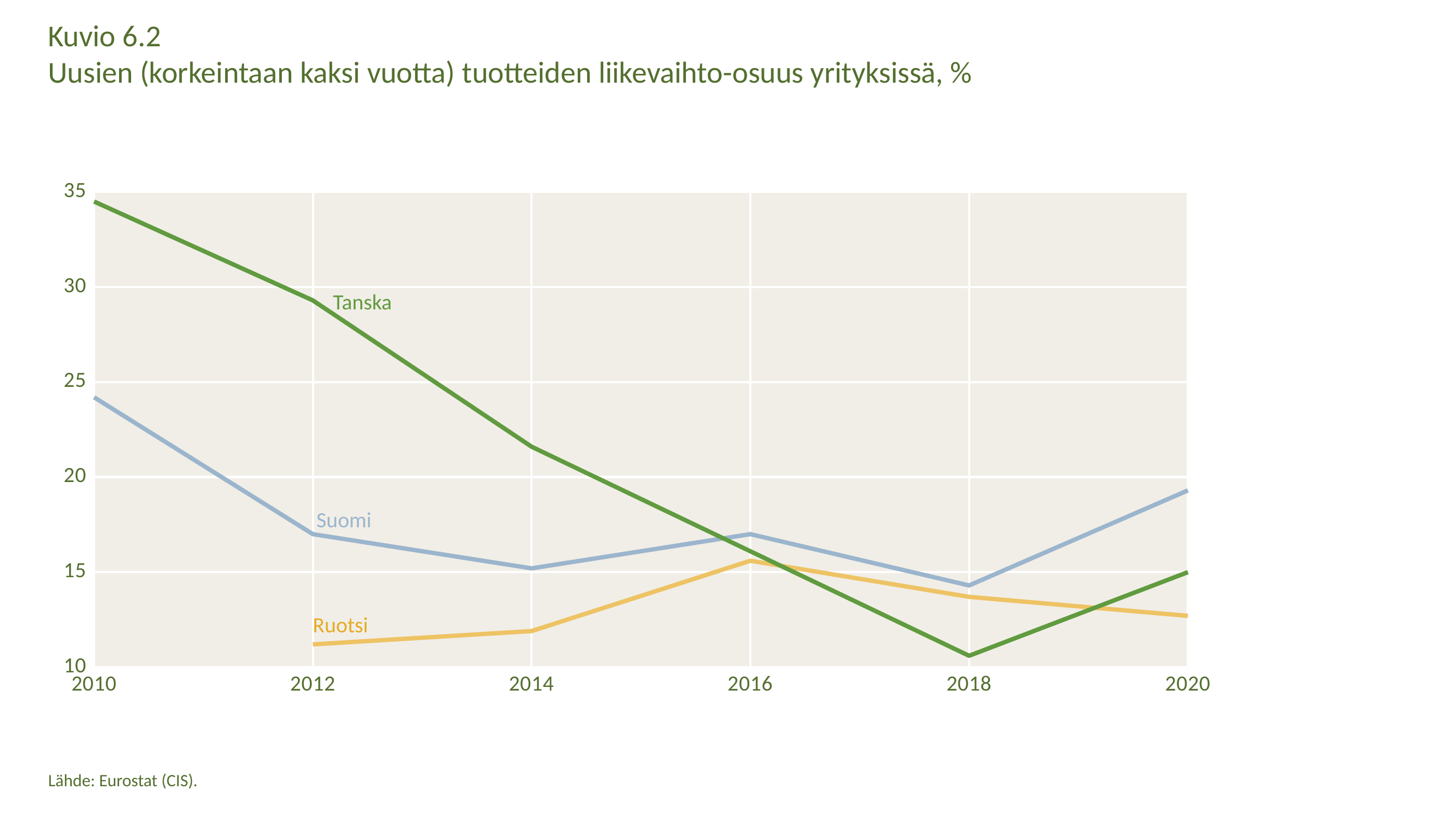
How many series (countries) are plotted on the chart? 3 Is the value for Suomi in 2020 greater or less than 20? less What kind of chart is shown on the slide? line chart What is the source given for the chart? Eurostat (CIS) Is the value for Ruotsi in 2012 greater or less than 15? less In 2014, which is larger: the value for Tanska or the value for Suomi? Tanska Which country has the highest value in 2010? Tanska In 2020, which is larger: the value for Suomi or the value for Ruotsi? Suomi Which country has the lowest value in 2018? Tanska Does the value for Tanska rise or fall from 2010 to 2018? fall Is the value for Tanska in 2010 greater or less than 30? greater